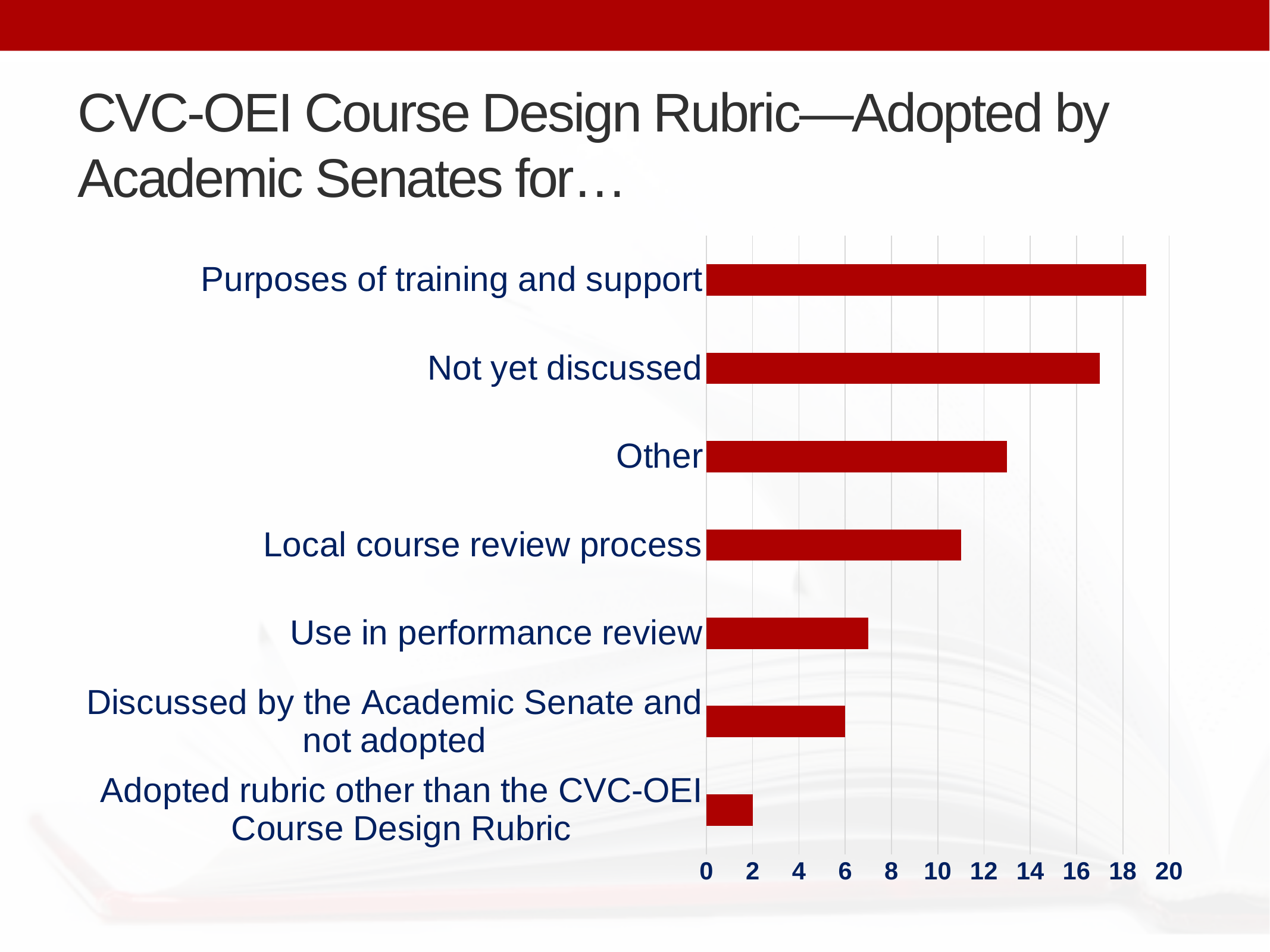
What is the value for "Adopted rubric other than the CVC-OEI Course Design Rubric"? 2 How many categories does the chart show? 7 What kind of chart is shown on the slide? bar chart Which is larger, the value for "Other" or the value for "Use in performance review"? Other Is the value for "Other" greater or less than 14? less Is the value for "Local course review process" greater or less than 10? greater Is the value for "Not yet discussed" greater or less than 16? greater Which category has the highest value? Purposes of training and support Which category has the lowest value? Adopted rubric other than the CVC-OEI Course Design Rubric What is the difference between the values for "Discussed by the Academic Senate and not adopted" and "Adopted rubric other than the CVC-OEI Course Design Rubric"? 4 What is the value for "Discussed by the Academic Senate and not adopted"? 6